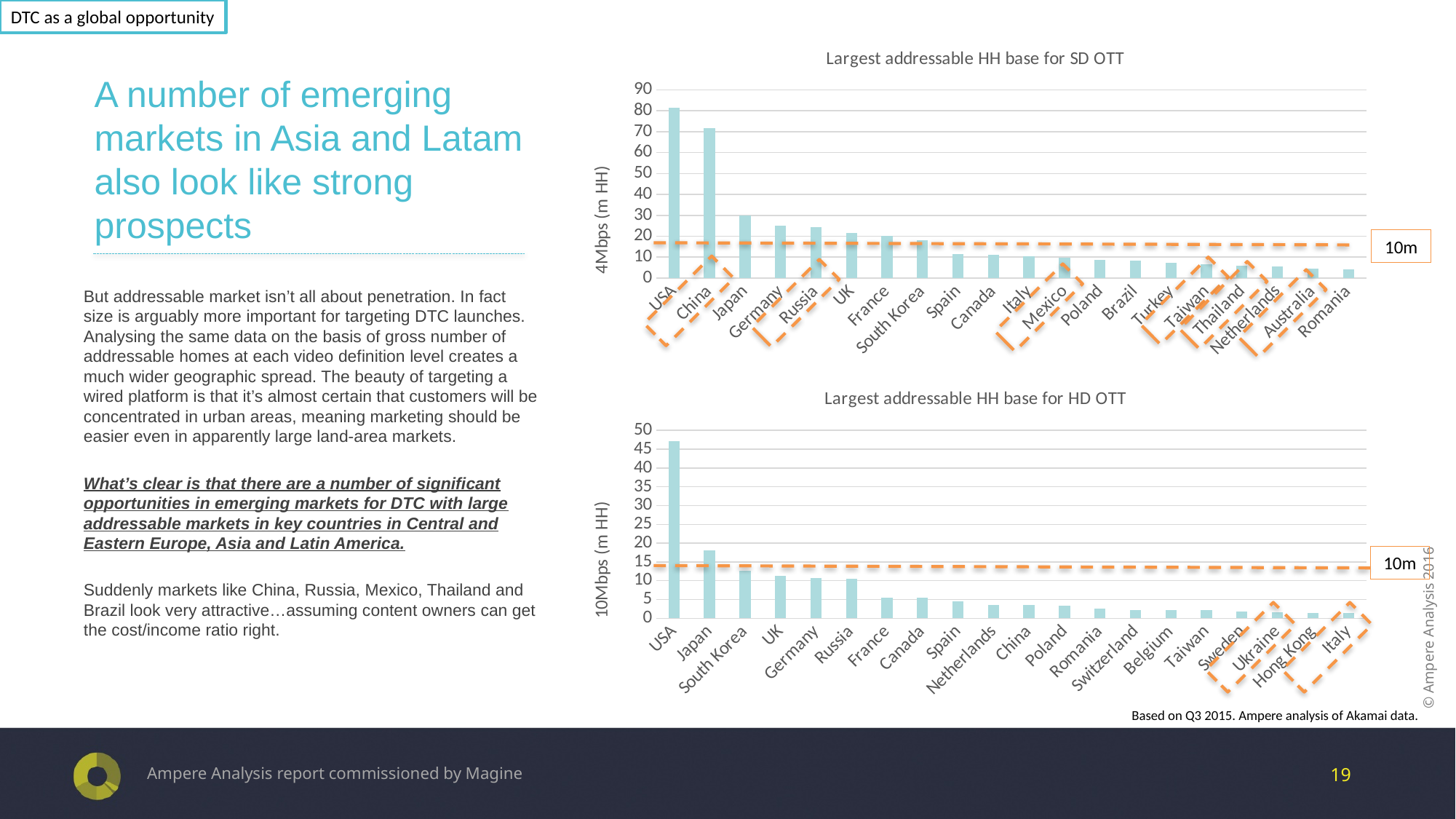
In the 'Largest addressable HH base for HD OTT' chart, is the value for USA greater or less than 40? greater In the 'Largest addressable HH base for SD OTT' chart, is the value for USA greater or less than 70? greater In the 'Largest addressable HH base for HD OTT' chart, which country has the highest value? USA In the 'Largest addressable HH base for SD OTT' chart, which country has the highest value? USA How many countries are shown in the 'Largest addressable HH base for HD OTT' chart? 20 In the 'Largest addressable HH base for HD OTT' chart, do the values rise or fall from left to right? fall In the 'Largest addressable HH base for SD OTT' chart, is the value for Germany greater or less than 20? greater What type of chart is the 'Largest addressable HH base for SD OTT' chart? bar chart What is the y-axis label of the 'Largest addressable HH base for HD OTT' chart? 10Mbps (m HH) In the 'Largest addressable HH base for SD OTT' chart, which country has the lowest value? Romania In the 'Largest addressable HH base for SD OTT' chart, which is larger, China or Japan? China How many countries are shown in the 'Largest addressable HH base for SD OTT' chart? 20